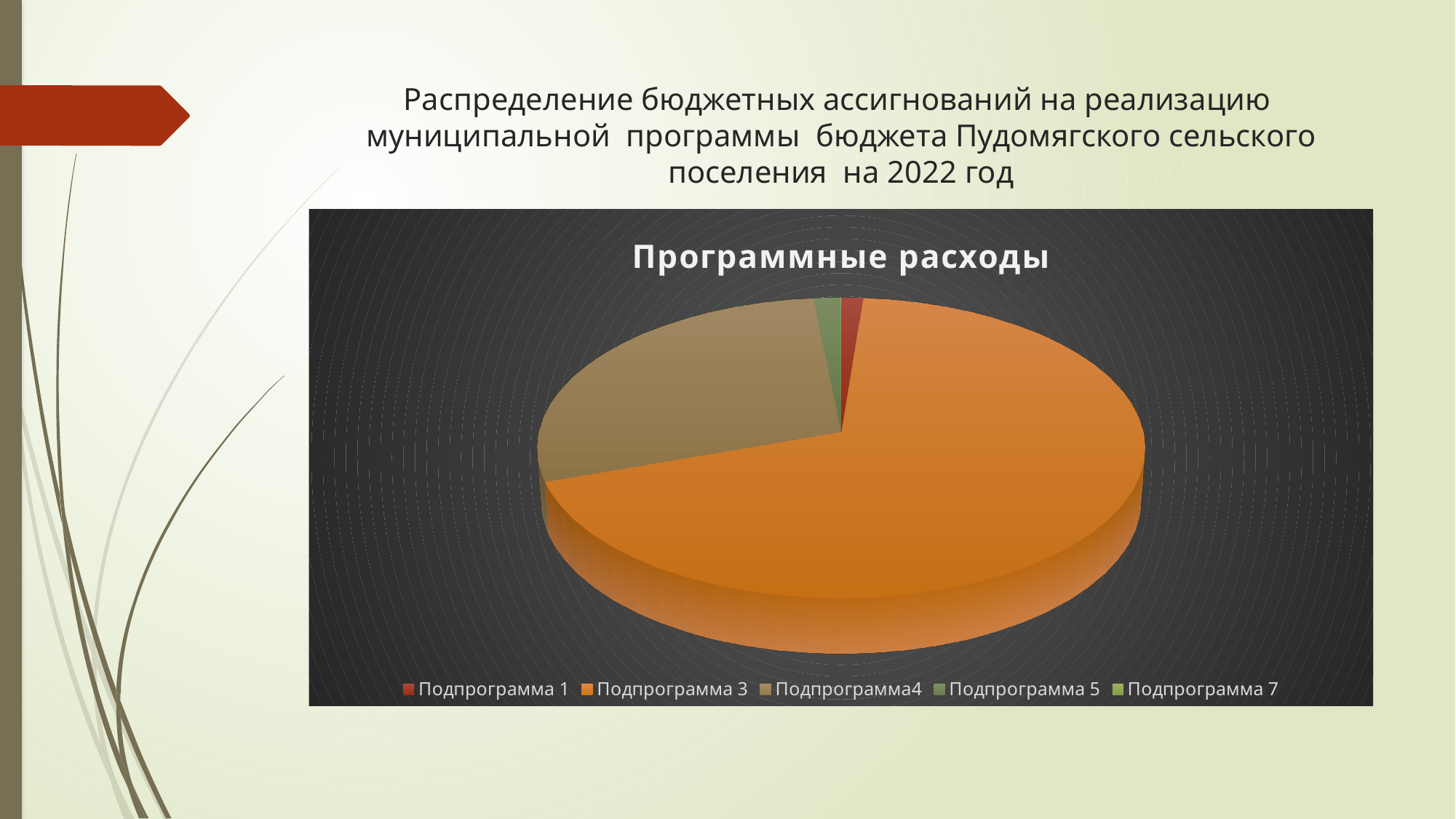
What is the title of the pie chart? Программные расходы Which subprogram has the largest slice in the pie chart? Подпрограмма 3 What kind of chart is shown on the slide? pie chart Which subprogram has the second-largest slice in the pie chart? Подпрограмма4 Which slice is larger, Подпрограмма 3 or Подпрограмма4? Подпрограмма 3 How many entries does the legend of the pie chart list? 5 What colour is the slice for Подпрограмма 3 in the pie chart? orange Which slice is larger, Подпрограмма 3 or Подпрограмма 5? Подпрограмма 3 Which slice is larger, Подпрограмма4 or Подпрограмма 1? Подпрограмма4